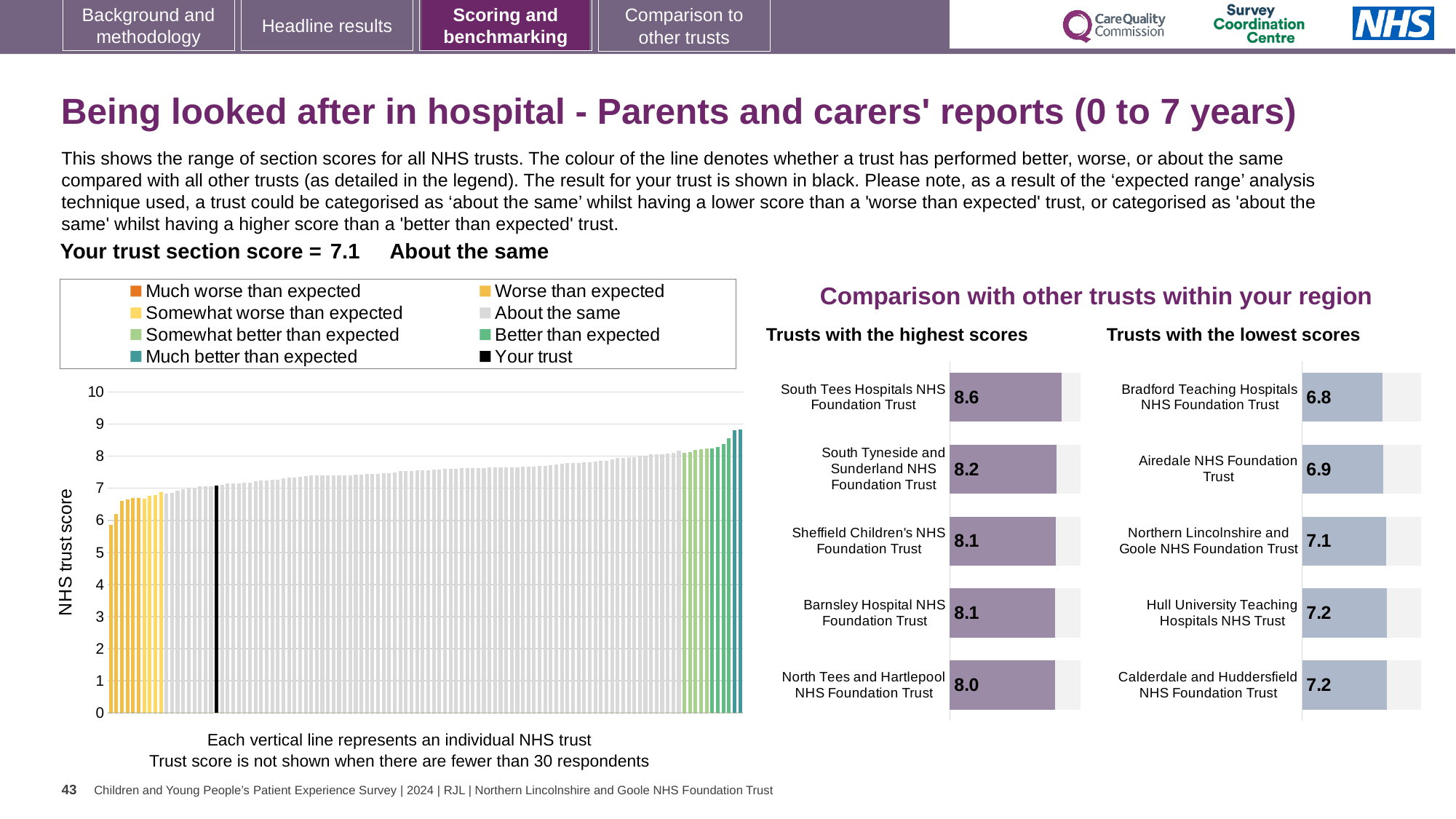
In the left-hand NHS trust score chart, is the value of the leftmost bar greater or less than 7? less What is the section score for your trust shown on the slide? 7.1 What kind of chart is the large chart on the left showing NHS trust scores? bar chart In the 'Trusts with the lowest scores' chart, what is the score for Airedale NHS Foundation Trust? 6.9 In the left-hand NHS trust score chart, is the value of the rightmost bar greater or less than 8? greater In the 'Trusts with the lowest scores' chart, which trust has the lowest score? Bradford Teaching Hospitals NHS Foundation Trust Which is larger: the score for South Tees Hospitals NHS Foundation Trust in the 'Trusts with the highest scores' chart or the score for Bradford Teaching Hospitals NHS Foundation Trust in the 'Trusts with the lowest scores' chart? South Tees Hospitals NHS Foundation Trust In the 'Trusts with the highest scores' chart, how many trusts are listed? 5 How many entries does the legend of the left-hand NHS trust score chart list? 8 In the 'Trusts with the highest scores' chart, what is the score for South Tees Hospitals NHS Foundation Trust? 8.6 In the 'Trusts with the highest scores' chart, what is the difference between the scores of South Tees Hospitals NHS Foundation Trust and North Tees and Hartlepool NHS Foundation Trust? 0.6 In the left-hand NHS trust score chart, do the bars rise or fall from left to right? rise